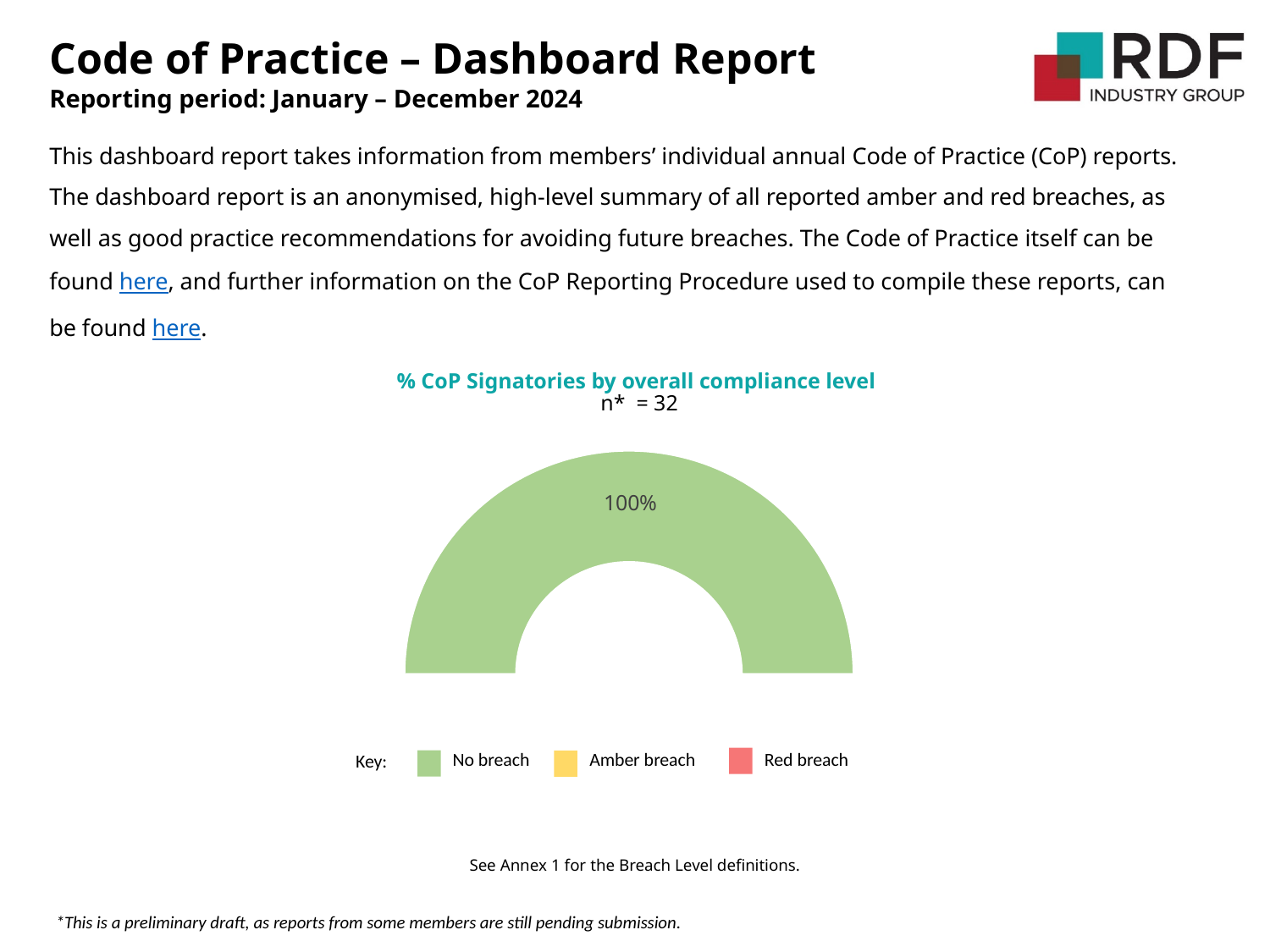
Which colour represents 'No breach' in the key? Green How many categories does the key list for the chart? 3 What percentage of CoP signatories are shown as having no breach? 100% What kind of chart is shown on the slide? Donut (pie) chart Which compliance category has the highest share in the chart? No breach What is the value of n* stated under the chart title? 32 What is the title of the chart on the slide? % CoP Signatories by overall compliance level How many segments are visibly plotted in the chart? 1 Is the share for 'No breach' greater or less than 50%? greater What share of the chart does the 'No breach' segment take up? 100%